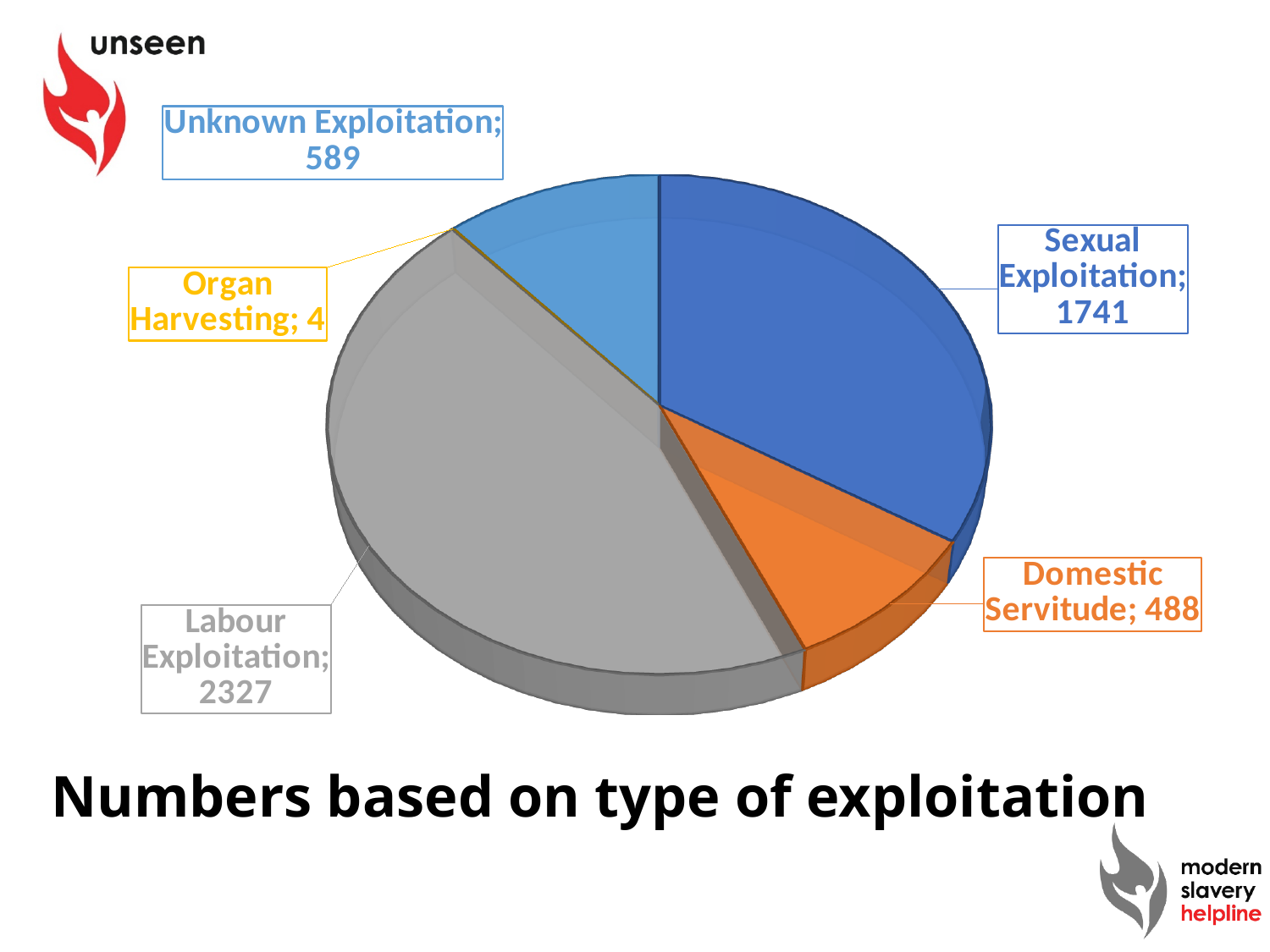
What is the title of the chart? Numbers based on type of exploitation What is the value for Domestic Servitude? 488 What is the value for Labour Exploitation? 2327 What is the value for Sexual Exploitation? 1741 What is the value for Organ Harvesting? 4 How many types of exploitation are shown in the pie chart? 5 What kind of chart is shown on the slide? Pie chart Which type of exploitation has the lowest number? Organ Harvesting What colour is the Domestic Servitude slice? Orange Which type of exploitation has the highest number? Labour Exploitation What is the difference between Labour Exploitation and Sexual Exploitation? 586 Which is larger, Unknown Exploitation or Domestic Servitude? Unknown Exploitation